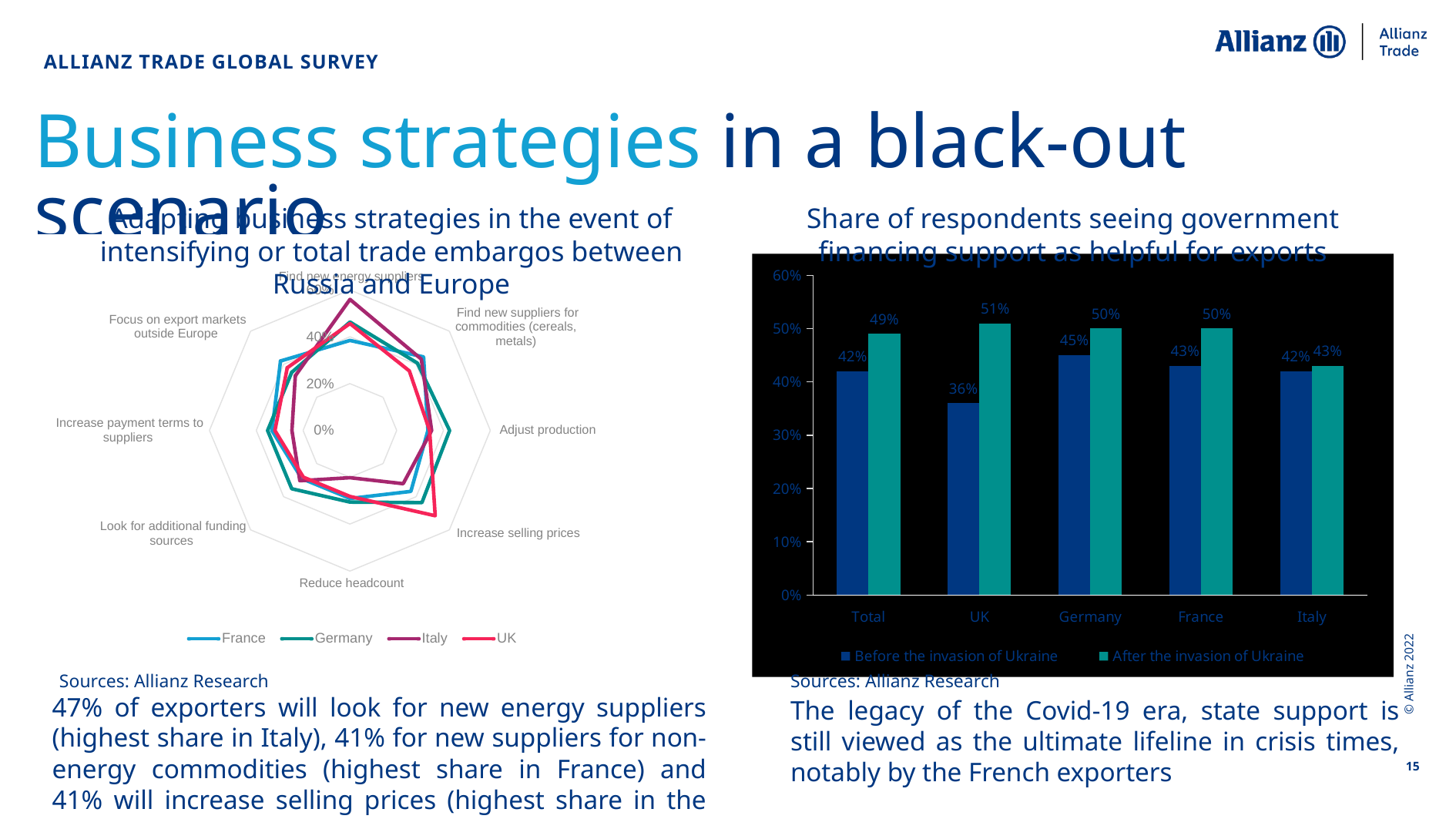
On the left chart, how many countries does the legend list? 4 On the right chart, is the value for Italy after the invasion of Ukraine larger or smaller than the value for France after the invasion of Ukraine? smaller On the right chart, which category has the highest value after the invasion of Ukraine? UK On the right chart, how many categories are shown on the x axis? 5 On the left chart, how many business strategies are plotted around the radar? 8 On the left chart, is the value for the UK on 'Increase selling prices' greater or less than 40%? greater On the right chart, what share of respondents in the UK saw government financing support as helpful after the invasion of Ukraine? 51% On the right chart, how many series does the legend list? 2 On the right chart, what is the difference between the UK's values after and before the invasion of Ukraine? 15 percentage points On the right chart, which country has the lowest value before the invasion of Ukraine? UK On the right chart, what is the value for Germany before the invasion of Ukraine? 45% What kind of chart is the chart on the right of the slide? bar chart